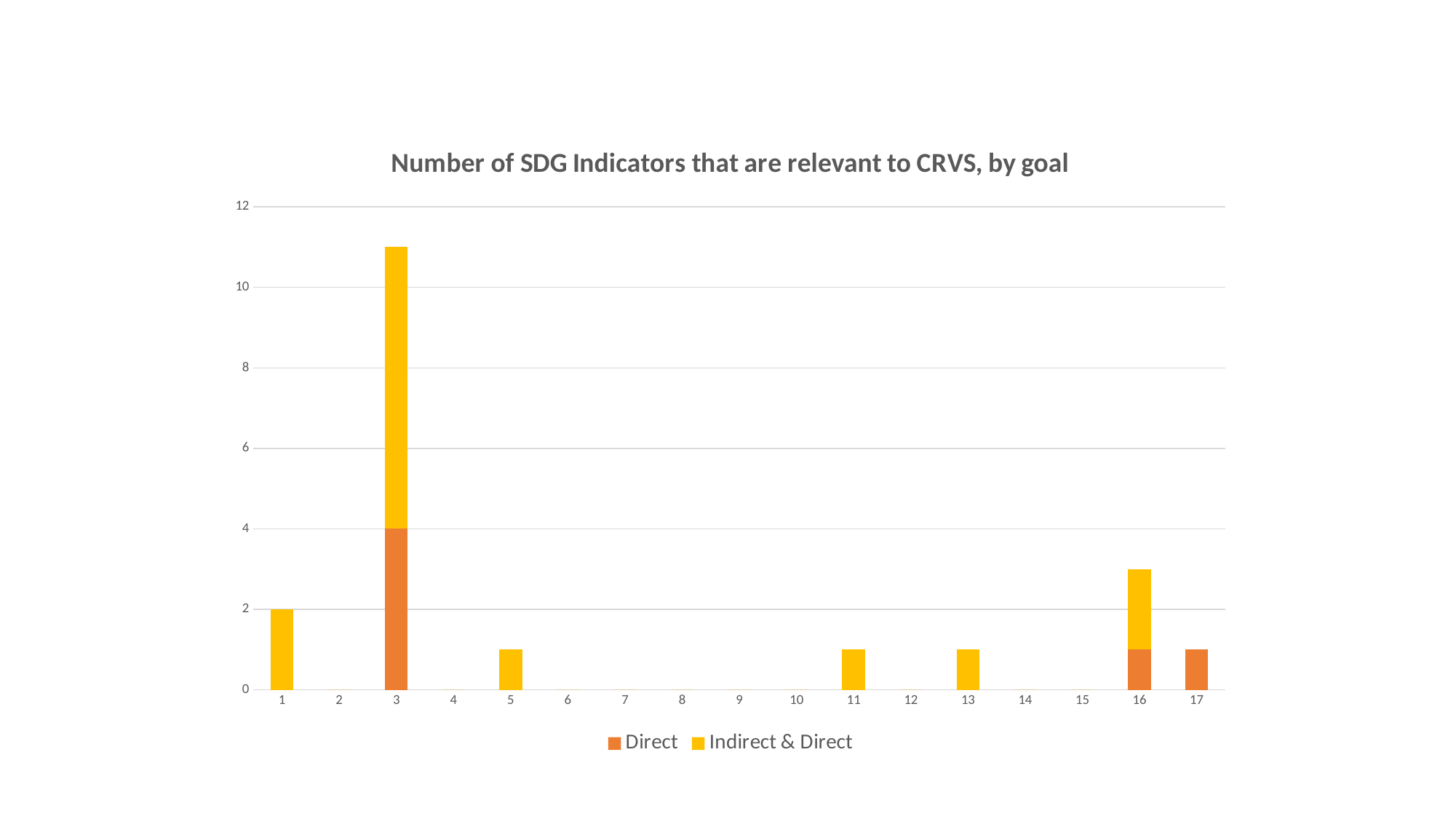
What are the two entries in the legend? Direct; Indirect & Direct How many series does the legend list? 2 Which goal has the highest total number of SDG indicators relevant to CRVS? 3 What is the total height of the bar for goal 1? 2 Which has a taller bar, goal 16 or goal 17? goal 16 Is the total value for goal 3 greater or less than 10? greater Is the total value for goal 16 greater or less than 2? greater Is the value for goal 5 greater or less than 2? less Which has a taller bar, goal 1 or goal 5? goal 1 What is the Direct value for goal 3? 4 How many goals are shown along the x axis? 17 What kind of chart is shown on the slide? bar chart